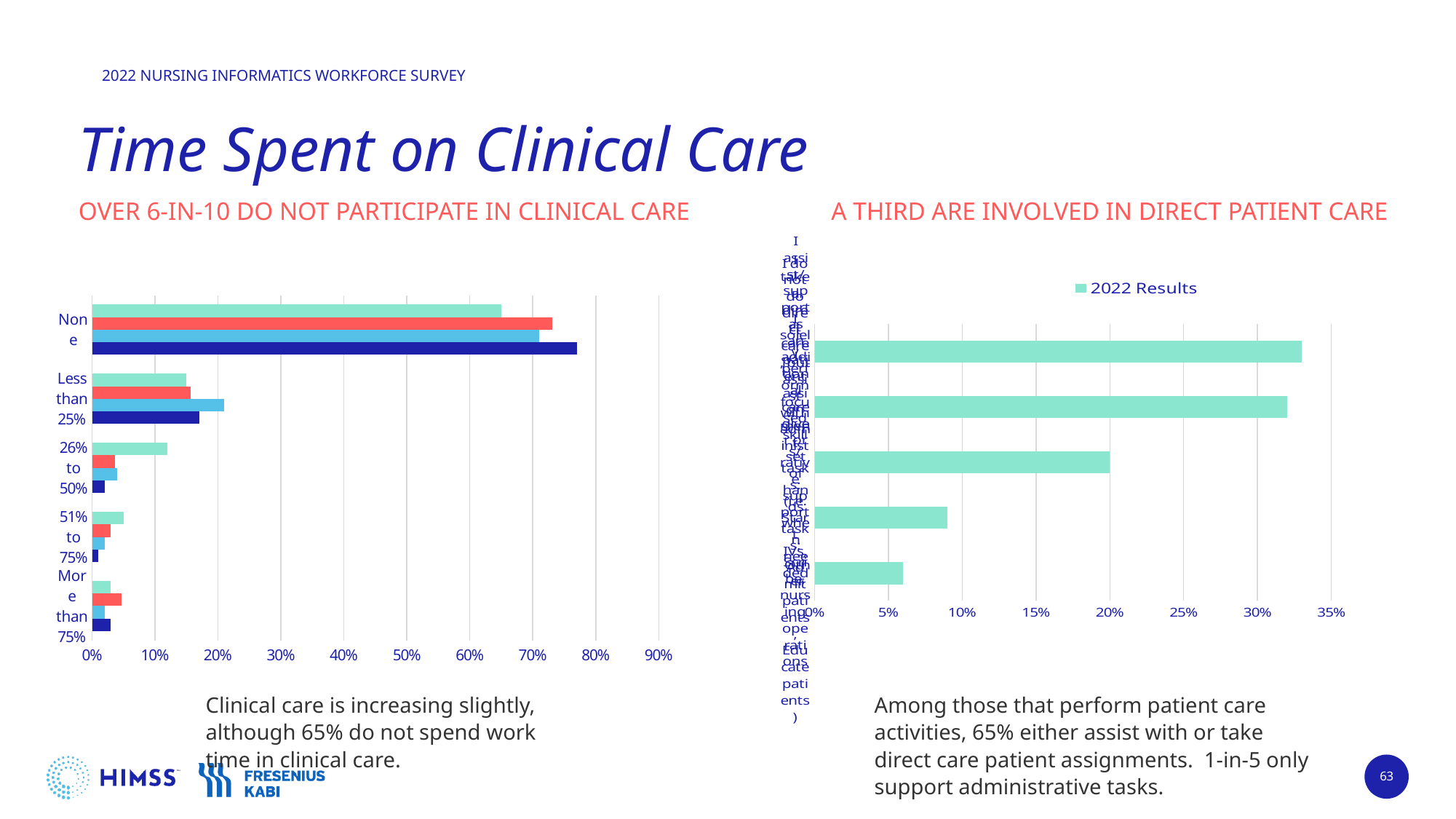
In the right chart, is the longest bar greater or less than 30%? greater In the left chart, which category has larger values, 'None' or '26% to 50%'? None In the left chart, which category has the longest bars? None In the left chart, are the values for 'Less than 25%' greater or less than 30%? less In the right chart, how many series does the legend list? 1 In the left chart, how many bars are plotted for each category? 4 In the right chart, how many bars are plotted? 5 In the left chart, how many categories are shown on the vertical axis? 5 In the left chart, are the values for 'None' greater or less than 60%? greater What kind of chart is the right chart titled 'A THIRD ARE INVOLVED IN DIRECT PATIENT CARE'? Bar chart In the right chart, what is the name of the series shown in the legend? 2022 Results What kind of chart is the left chart titled 'OVER 6-IN-10 DO NOT PARTICIPATE IN CLINICAL CARE'? Bar chart